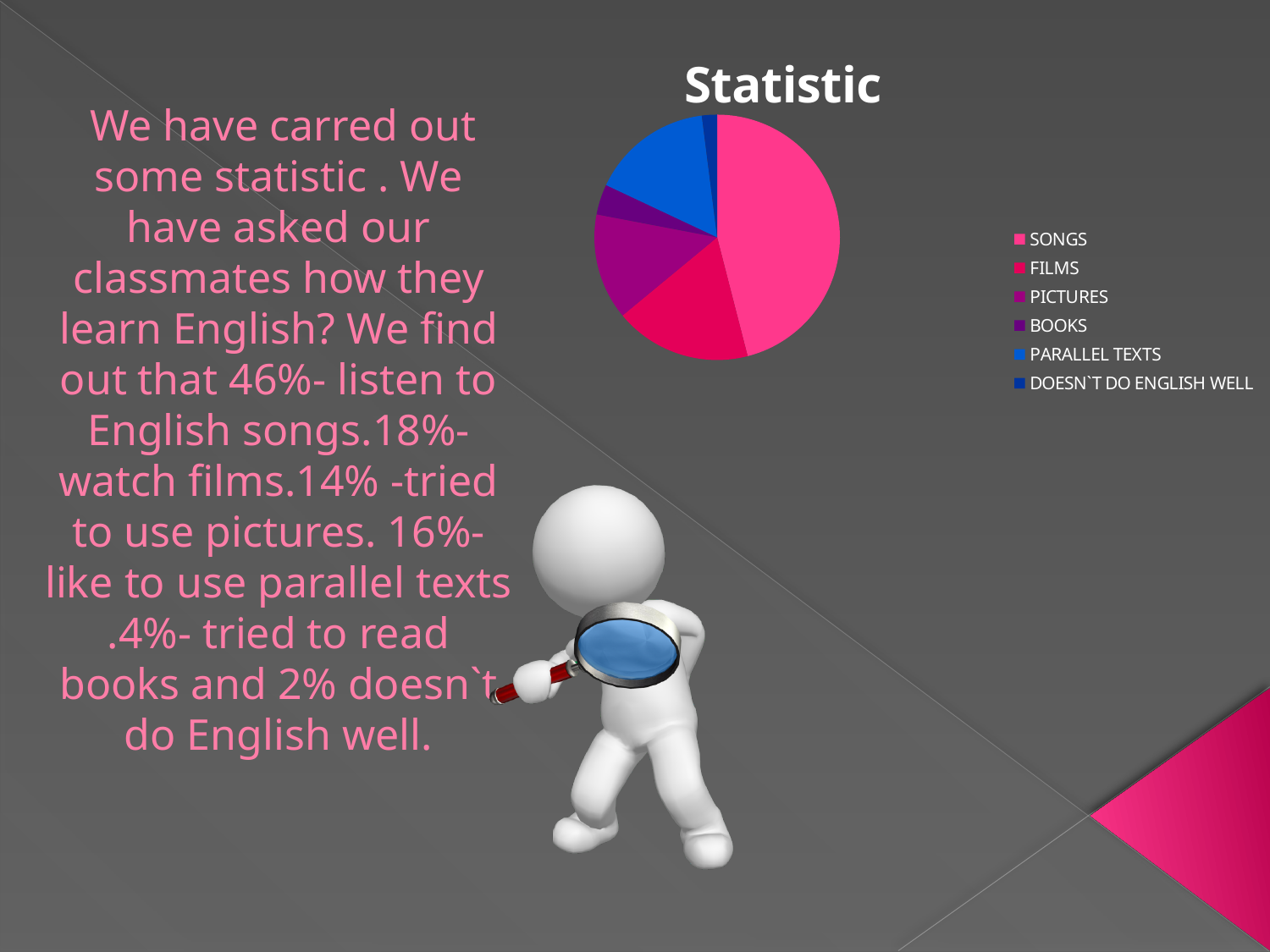
What kind of chart is shown on the slide? pie chart Which category has the largest slice of the pie? SONGS According to the slide, what share of the pie is SONGS? 46% Which slice is larger, FILMS or BOOKS? FILMS How many entries does the chart legend list? 6 What colour is the SONGS slice in the legend? pink What is the title of the chart? Statistic Which slice is larger, SONGS or FILMS? SONGS How many categories does the pie chart have? 6 Which slice is larger, BOOKS or DOESN`T DO ENGLISH WELL? BOOKS Which category has the smallest slice of the pie? DOESN`T DO ENGLISH WELL According to the slide, what share of the pie is FILMS? 18%